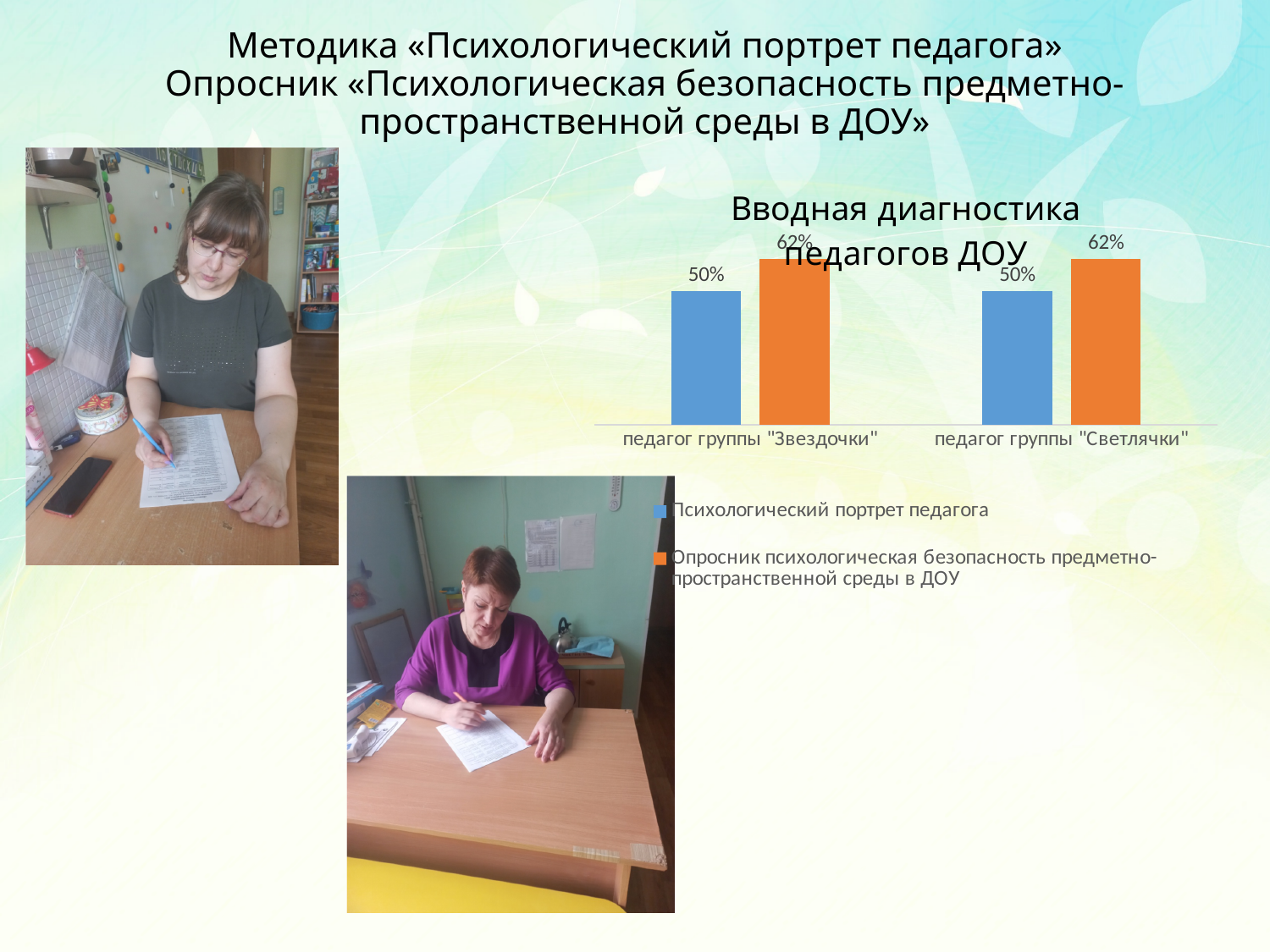
Which colour represents the series «Психологический портрет педагога» in the chart? blue What type of chart is shown on the slide? bar chart What is the value of «Психологический портрет педагога» for педагог группы "Светлячки"? 50% What is the difference between the «Опросник» value and the «Психологический портрет педагога» value for педагог группы "Светлячки"? 12% What is the value of «Опросник психологическая безопасность предметно-пространственной среды в ДОУ» for педагог группы "Звездочки"? 62% For педагог группы "Звездочки", which series has the larger value: «Психологический портрет педагога» or «Опросник психологическая безопасность предметно-пространственной среды в ДОУ»? Опросник психологическая безопасность предметно-пространственной среды в ДОУ What is the value of «Опросник психологическая безопасность предметно-пространственной среды в ДОУ» for педагог группы "Светлячки"? 62% What is the title of the chart? Вводная диагностика педагогов ДОУ How many series does the chart legend list? 2 What is the value of «Психологический портрет педагога» for педагог группы "Звездочки"? 50% What is the difference between the «Психологический портрет педагога» values for педагог группы "Звездочки" and педагог группы "Светлячки"? 0% How many categories are shown on the x axis of the chart? 2